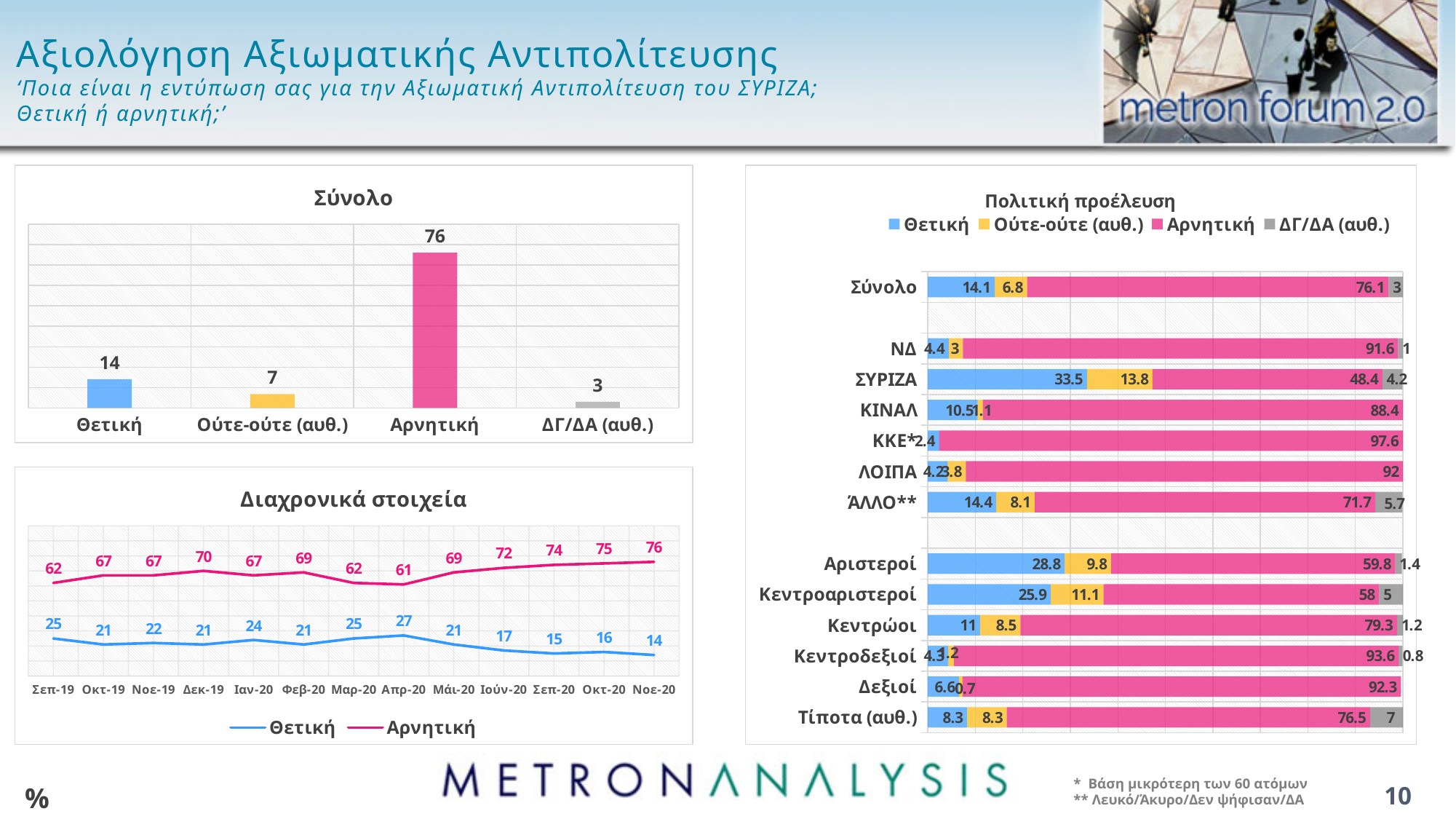
In the 'Διαχρονικά στοιχεία' chart, what is the value of Αρνητική for Δεκ-19? 70 In the 'Σύνολο' chart, what is the difference between Αρνητική and Θετική? 62 In the 'Πολιτική προέλευση' chart, how many series does the legend list? 4 In the 'Διαχρονικά στοιχεία' chart, what is the highest value of the Θετική series? 27 In the 'Σύνολο' chart, how many categories are shown? 4 In the 'Σύνολο' chart, what is the value for Αρνητική? 76 In the 'Διαχρονικά στοιχεία' chart, how many series does the legend list? 2 In the 'Πολιτική προέλευση' chart, what is the Θετική value for ΣΥΡΙΖΑ? 33.5 In the 'Πολιτική προέλευση' chart, which category has the highest Αρνητική value? ΚΚΕ* In the 'Σύνολο' chart, which category has the lowest value? ΔΓ/ΔΑ (αυθ.) In the 'Διαχρονικά στοιχεία' chart, does the Αρνητική series rise or fall from Απρ-20 to Νοε-20? rise What kind of chart is 'Διαχρονικά στοιχεία'? line chart